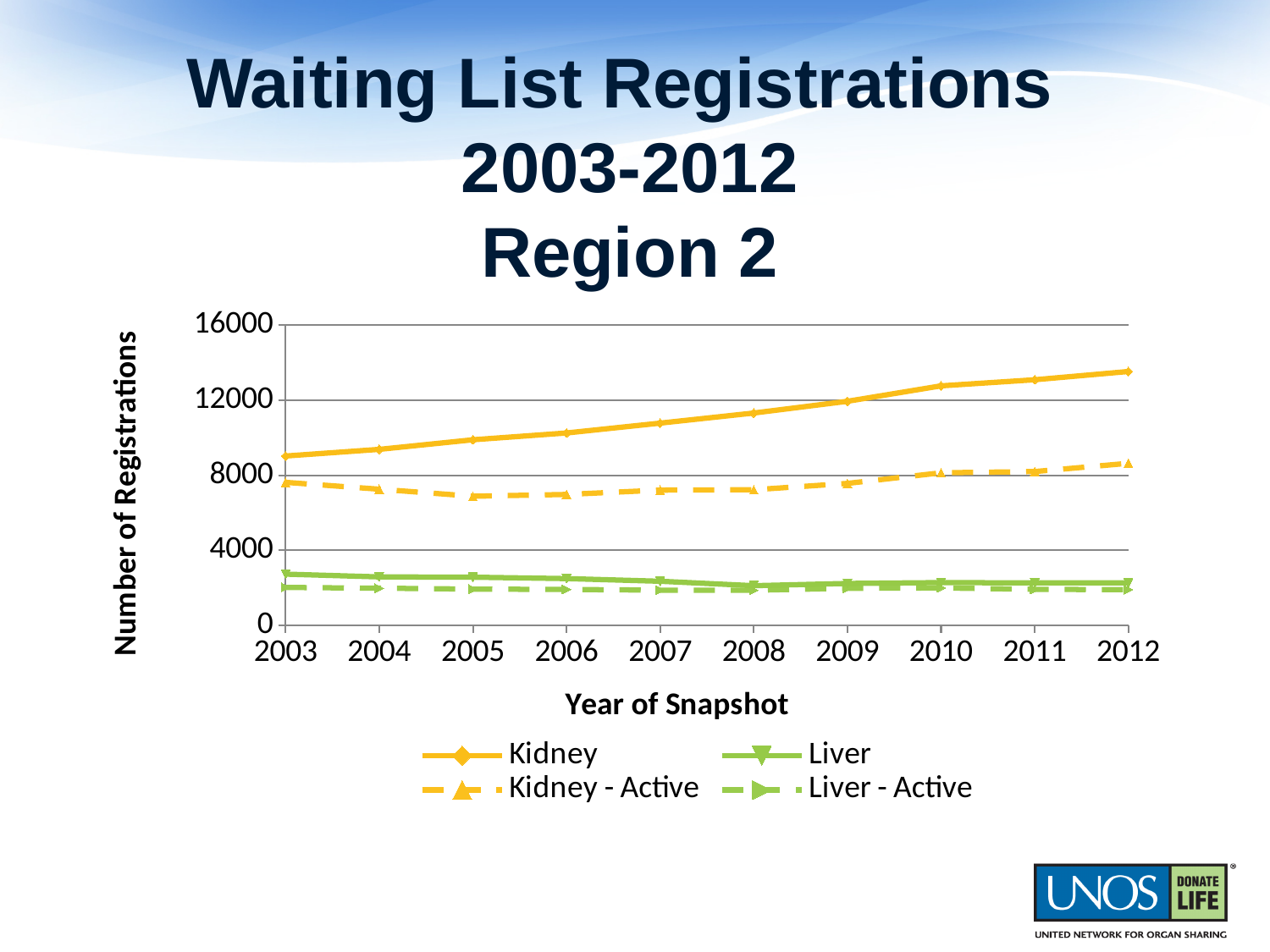
Does the Kidney series rise or fall from 2003 to 2012? rise How many series does the legend list? 4 Which series is larger in 2012, Kidney or Liver? Kidney What is the label of the y axis? Number of Registrations Is the value for Kidney in 2003 greater or less than 8000? greater What kind of chart is shown on the slide? line chart Is the value for Liver in 2003 greater or less than 4000? less Is the value for Kidney - Active in 2005 greater or less than 8000? less How many years are plotted along the x axis? 10 In which year is the Kidney series at its highest? 2012 In which year is the Kidney series at its lowest? 2003